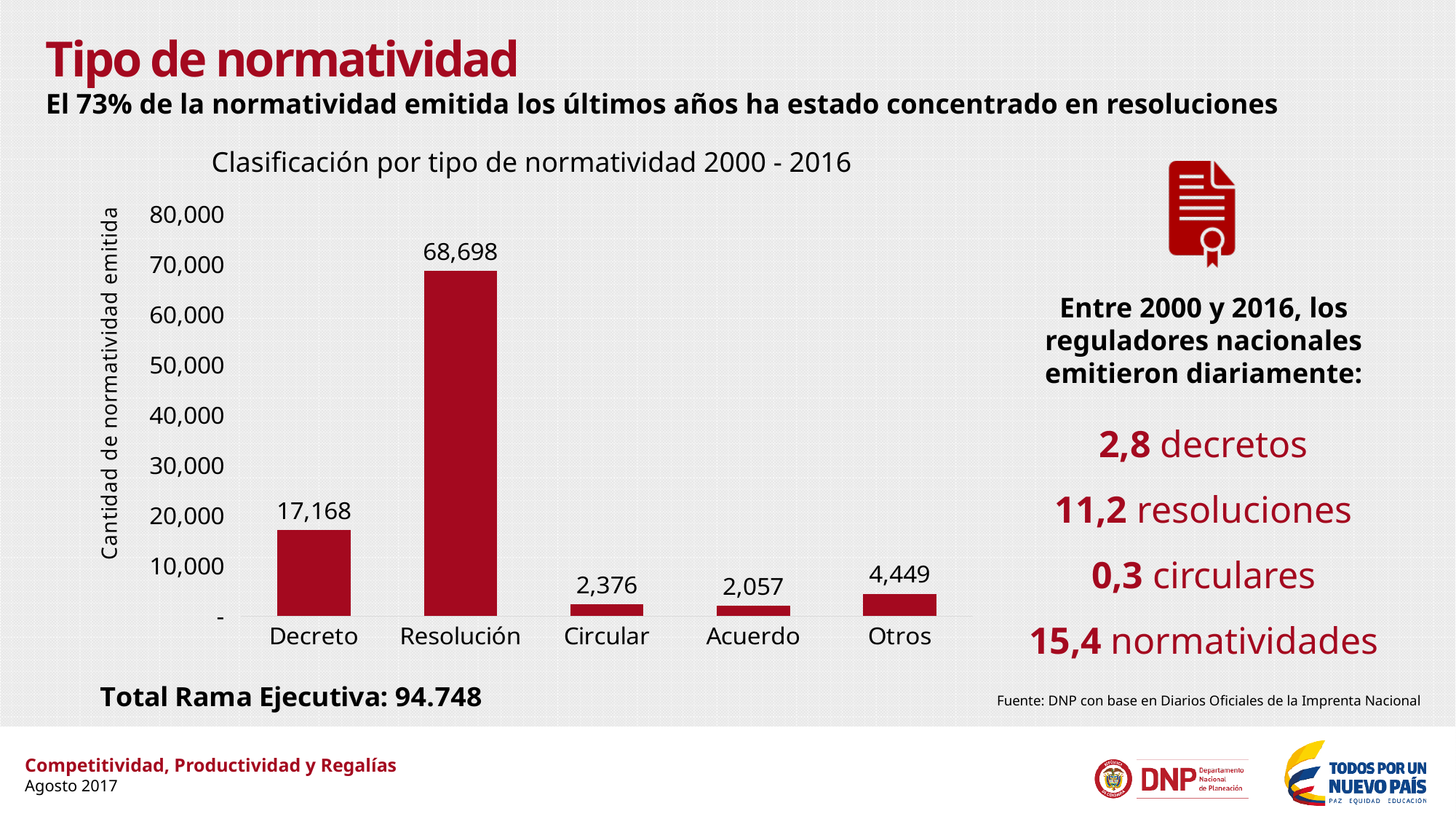
Which category has the highest value? Resolución What is the value for Resolución? 68,698 What is the difference between the values for Resolución and Decreto? 51,530 What kind of chart is shown on the slide? Bar chart What is the title of the chart? Clasificación por tipo de normatividad 2000 - 2016 What is the value for Otros? 4,449 Which is larger, the value for Otros or the value for Circular? Otros What is the value for Circular? 2,376 Which category has the lowest value? Acuerdo What is the value for Acuerdo? 2,057 What is the value for Decreto? 17,168 How many categories are shown on the x axis? 5